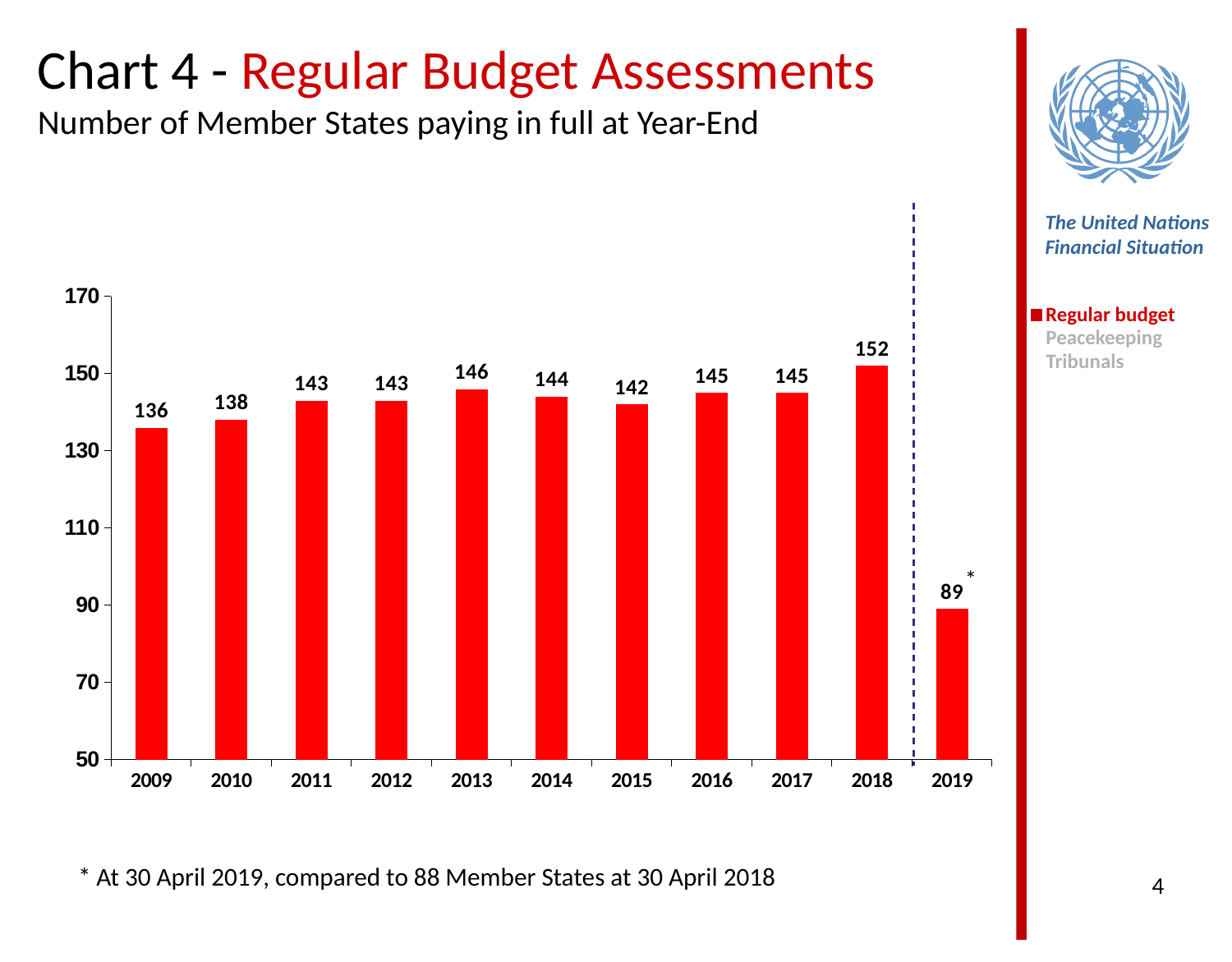
What kind of chart is shown on the slide? bar chart How many years are shown on the x axis? 11 What is the difference between the values for 2018 and 2009? 16 What is the number of Member States paying in full at year-end for 2018? 152 Which is larger, the value for 2011 or the value for 2013? 2013 What is the value shown for 2019? 89 What is the subtitle of the chart below 'Chart 4 - Regular Budget Assessments'? Number of Member States paying in full at Year-End Which year has the highest number of Member States paying in full? 2018 What is the value shown for 2009? 136 Which year has the lowest value on the chart? 2019 Is the value for 2019 greater or less than 110? less What is the difference between the values for 2013 and 2015? 4